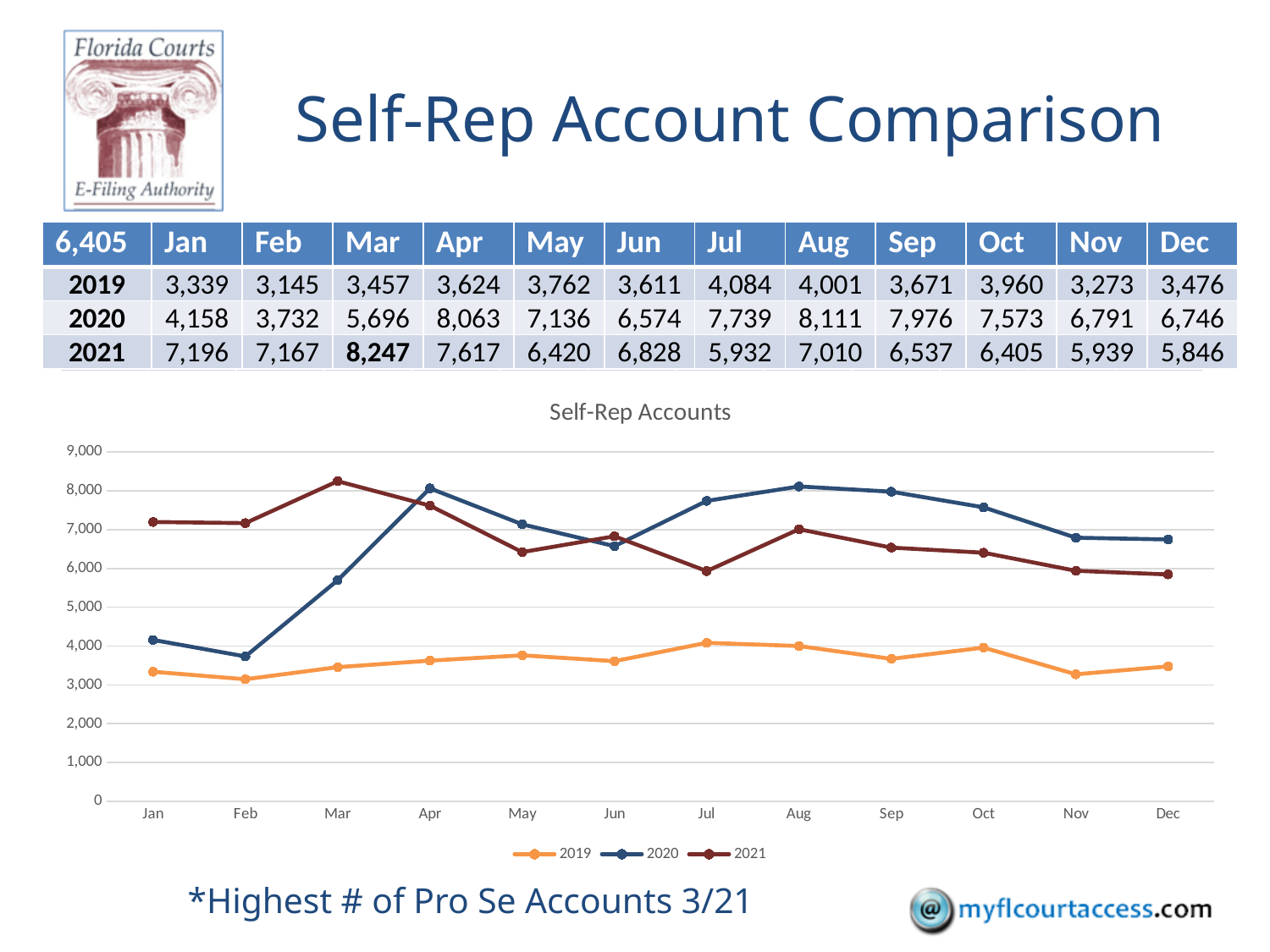
In which month is the 2020 series highest? Aug How many months are plotted along the x axis of the Self-Rep Accounts chart? 12 What is the value for 2020 in December? 6,746 What kind of chart is the Self-Rep Accounts chart? line chart What is the value for 2021 in March? 8,247 Which is larger in January, the 2020 value or the 2021 value? 2021 Is the value for 2020 in April greater or less than 7,000? greater What is the value for 2019 in July? 4,084 How many series does the legend of the Self-Rep Accounts chart list? 3 In which month is the 2019 series lowest? Feb Does the 2020 series rise or fall from January to April? rise What is the difference between the 2021 and 2020 values in March? 2,551